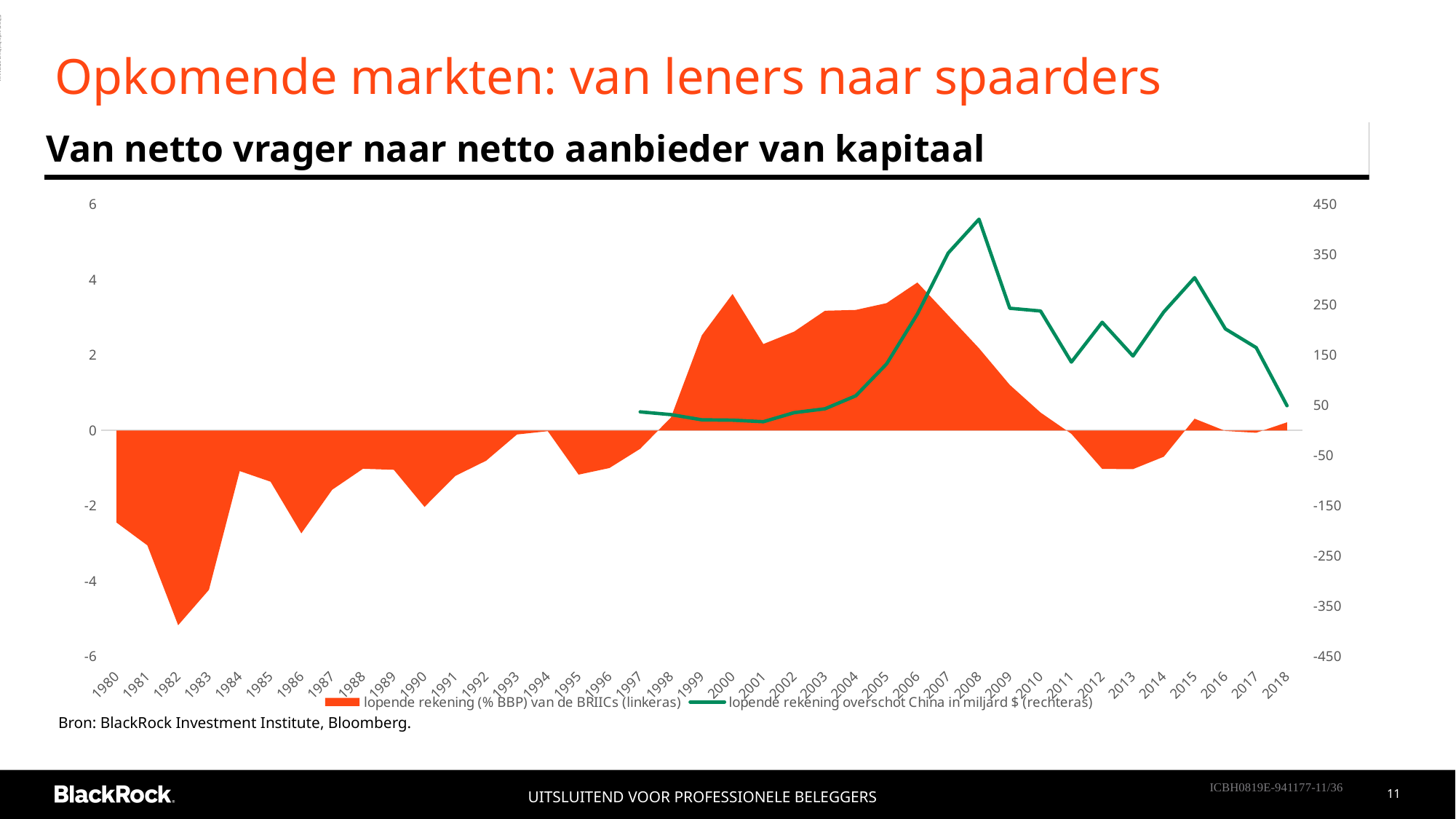
In which year does the green line (lopende rekening overschot China) reach its highest value? 2008 Is the value of the green line for 2018 greater or less than 150? less Is the value of the orange area for 1982 greater or less than -4? less Is the value of the green line for 2008 greater or less than 350? greater What kind of chart is shown on the slide? A combined area and line chart Does the green line rise or fall between 2015 and 2018? fall How many series does the legend list? 2 Which is higher for the green line: the value in 2008 or the value in 2015? 2008 How many years are shown on the x axis? 39 In which year does the orange area (lopende rekening % BBP van de BRIICs) reach its lowest value? 1982 Which axis does the legend say the green China series is plotted on? rechteras (right axis)